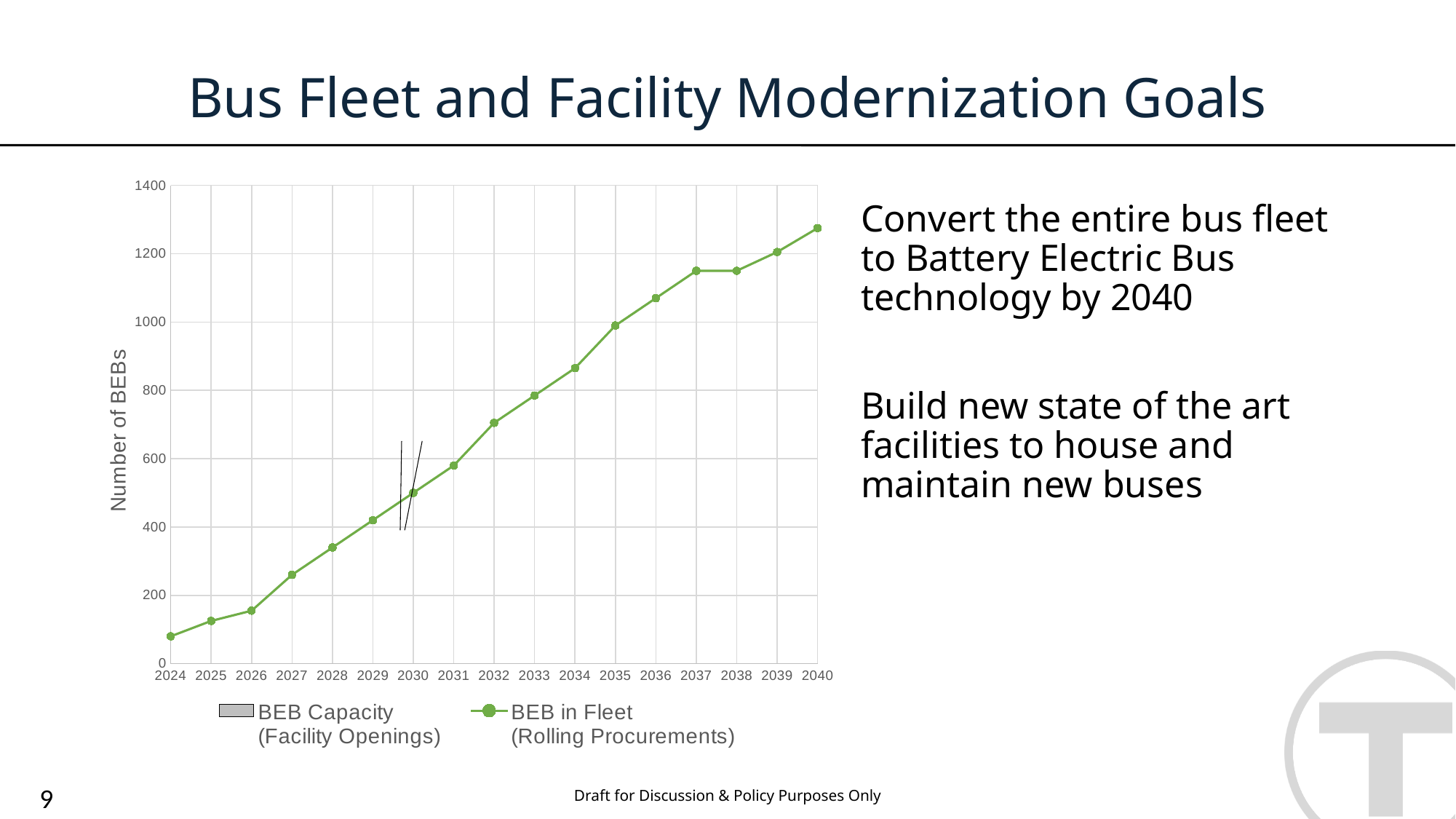
What kind of chart is shown on the slide? line chart Does the BEB in Fleet line rise or fall from 2024 to 2040? rise How many years are plotted along the x axis of the chart? 17 What is the label on the y axis of the chart? Number of BEBs In which year is the BEB in Fleet value lowest? 2024 Is the BEB in Fleet value for 2040 greater or less than 1200? greater In which year is the BEB in Fleet value highest? 2040 Which year has a larger BEB in Fleet value, 2030 or 2036? 2036 Is the BEB in Fleet value for 2028 greater or less than 400? less How many series does the chart legend list? 2 Is the BEB in Fleet value for 2032 greater or less than 600? greater